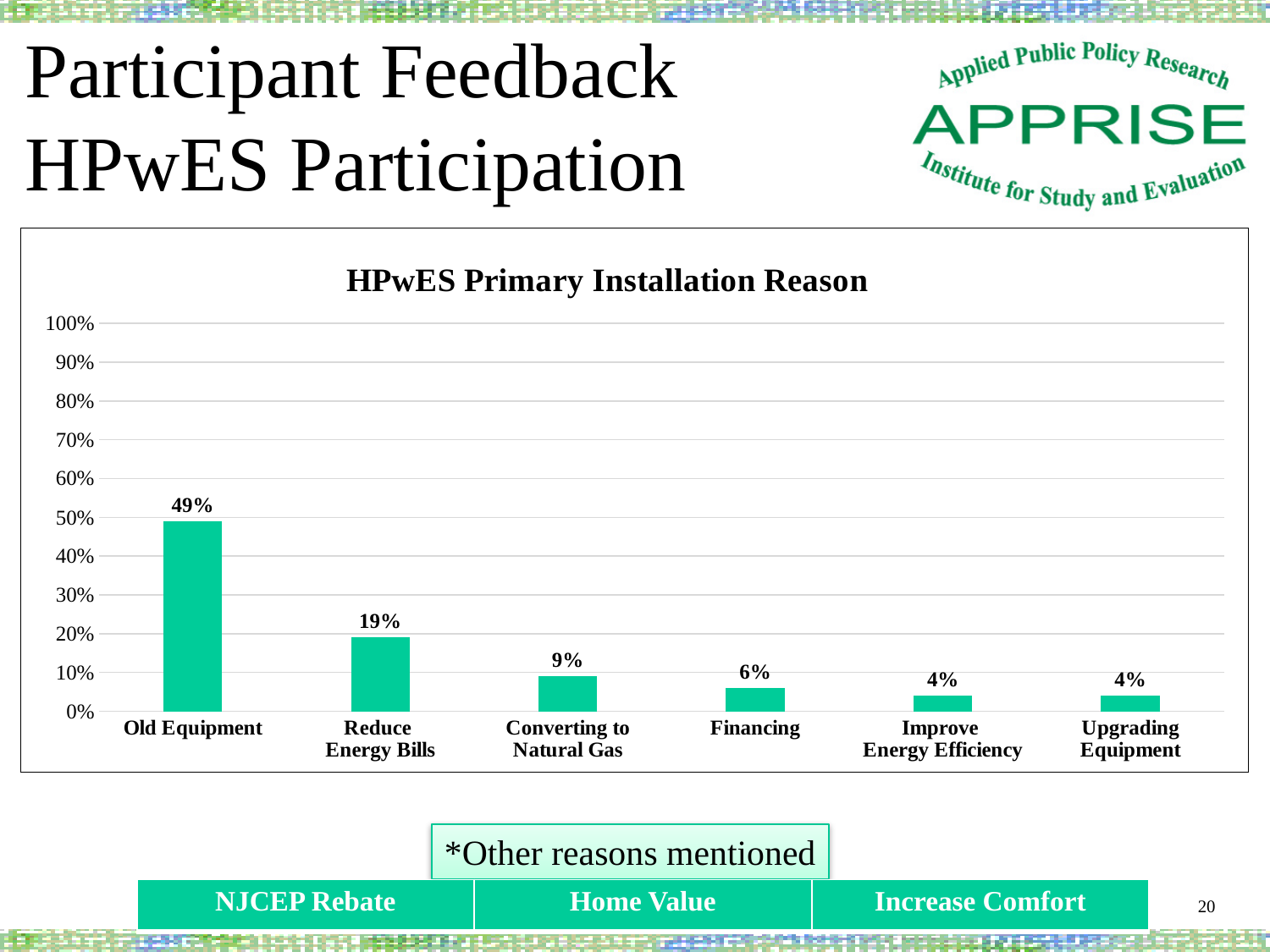
Which is larger, the value for Reduce Energy Bills or the value for Converting to Natural Gas? Reduce Energy Bills What is the title of the chart? HPwES Primary Installation Reason What is the value shown for Reduce Energy Bills? 19% What is the value shown for Financing? 6% What is the difference between the values for Old Equipment and Reduce Energy Bills? 30% Is the value for Old Equipment greater or less than 40%? greater What percentage of participants cited Old Equipment as their primary installation reason? 49% How many categories are shown on the x axis of the chart? 6 What kind of chart is shown on the slide? Bar chart What is the value shown for Converting to Natural Gas? 9% What is the difference between the values for Converting to Natural Gas and Financing? 3% Which category has the highest value in the chart? Old Equipment